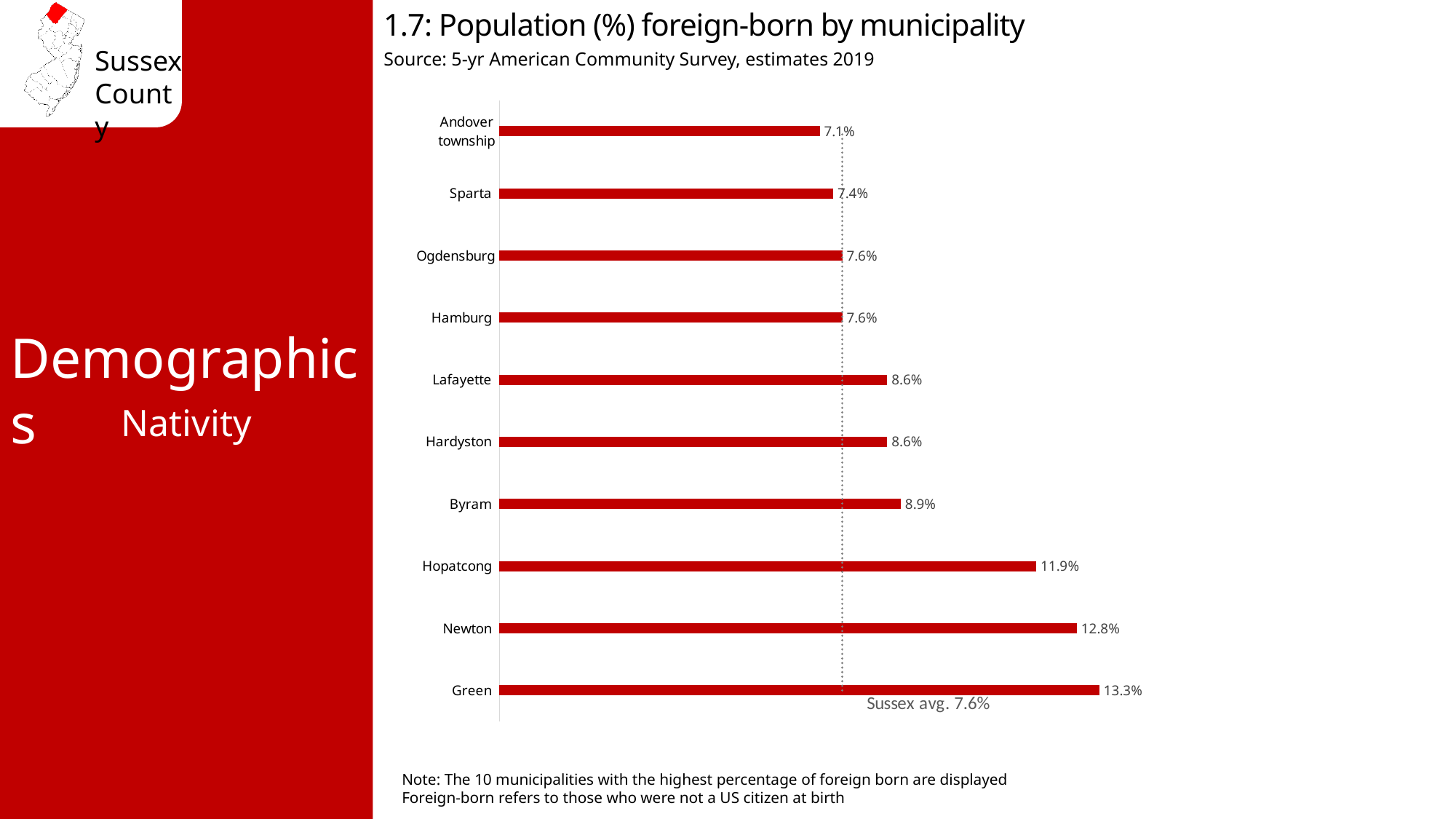
How many municipalities are shown on the chart? 10 What is the source of the data shown in the chart? 5-yr American Community Survey, estimates 2019 What is the foreign-born population percentage for Hopatcong? 11.9% What is the foreign-born population percentage for Green? 13.3% What is the Sussex County average foreign-born percentage marked by the dotted line? 7.6% What is the foreign-born population percentage for Sparta? 7.4% What is the difference in foreign-born percentage between Newton and Byram? 3.9% Which has a higher foreign-born percentage, Hopatcong or Lafayette? Hopatcong What type of chart is shown on the slide? Bar chart Which municipality has the highest foreign-born percentage? Green Which municipality has the lowest foreign-born percentage shown on the chart? Andover township What is the difference in foreign-born percentage between Green and Andover township? 6.2%